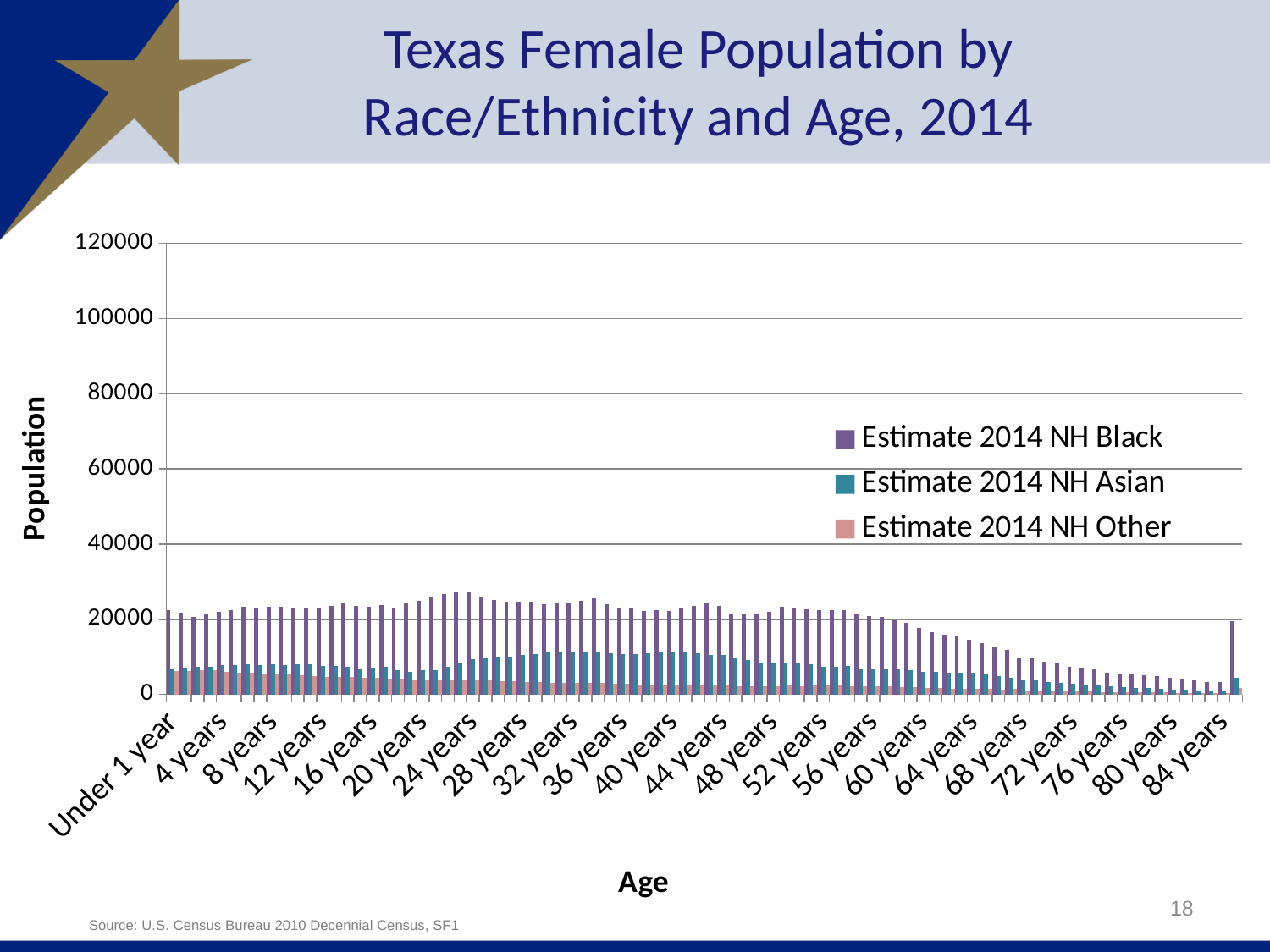
Is the value for Estimate 2014 NH Black at 64 years greater or less than 20000? less What is the label on the vertical axis of the chart? Population What is the title of the chart? Texas Female Population by Race/Ethnicity and Age, 2014 Which series has the lowest value at 40 years? Estimate 2014 NH Other At 4 years, which series has the larger value: Estimate 2014 NH Black or Estimate 2014 NH Asian? Estimate 2014 NH Black Which series has the highest value at 28 years? Estimate 2014 NH Black Is the value for Estimate 2014 NH Asian at 36 years greater or less than 20000? less What kind of chart is shown on the slide? Bar chart Is the value for Estimate 2014 NH Black at 8 years greater or less than 20000? greater Do the values for Estimate 2014 NH Black rise or fall from 60 years to 84 years? fall How many series does the legend list? 3